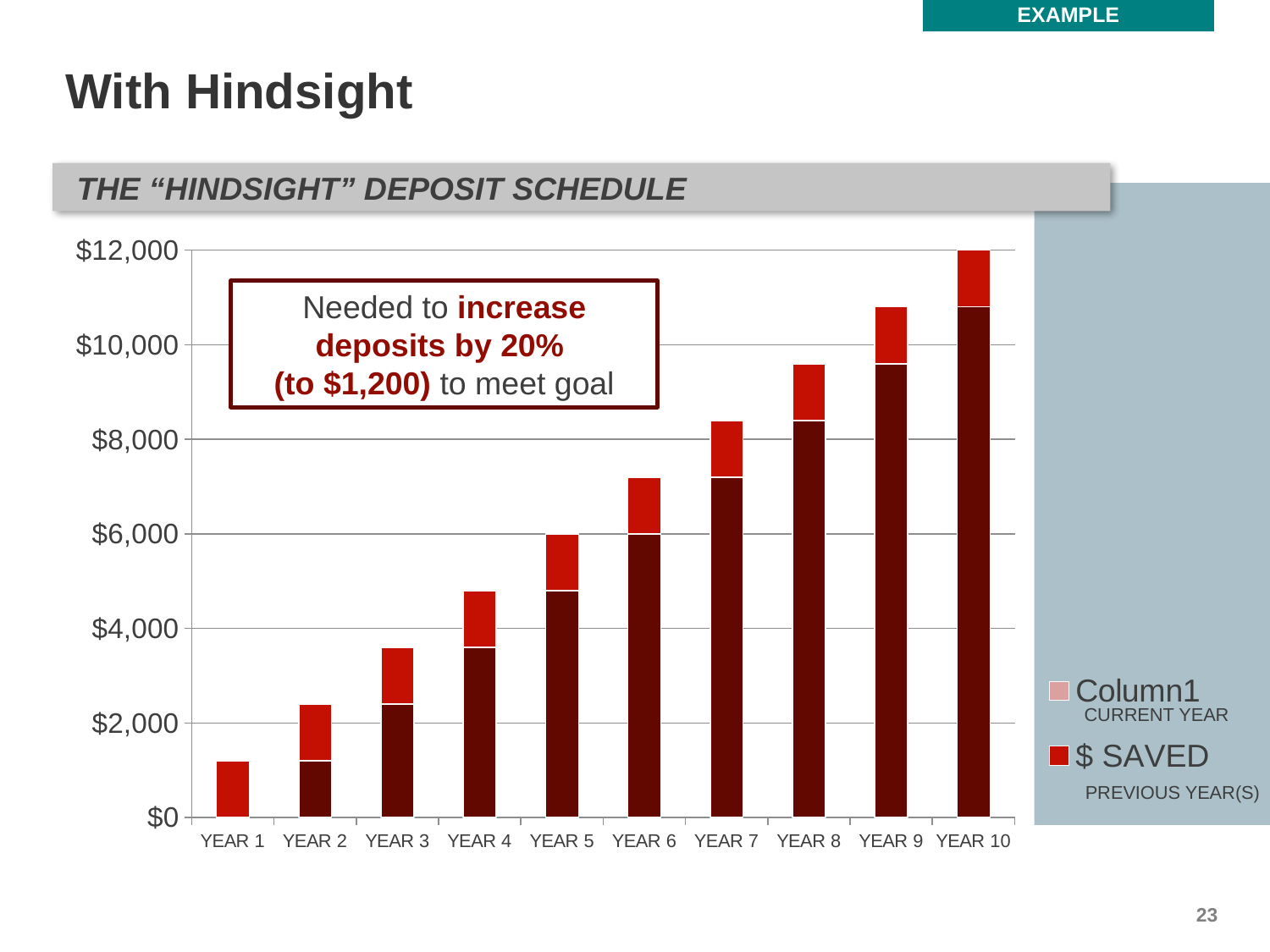
What is the title of the chart? THE "HINDSIGHT" DEPOSIT SCHEDULE Is the total bar height for YEAR 4 greater or less than $4,000? greater How many series does the legend list? 2 How many years (categories) are plotted on the x axis? 10 Which year has the tallest bar? YEAR 10 Which bar is taller, YEAR 3 or YEAR 7? YEAR 7 Is the total bar height for YEAR 1 greater or less than $2,000? less Is the total bar height for YEAR 9 greater or less than $10,000? greater Do the bar totals rise or fall from YEAR 1 to YEAR 10? Rise What kind of chart is shown on the slide? Stacked bar chart Which year has the shortest bar? YEAR 1